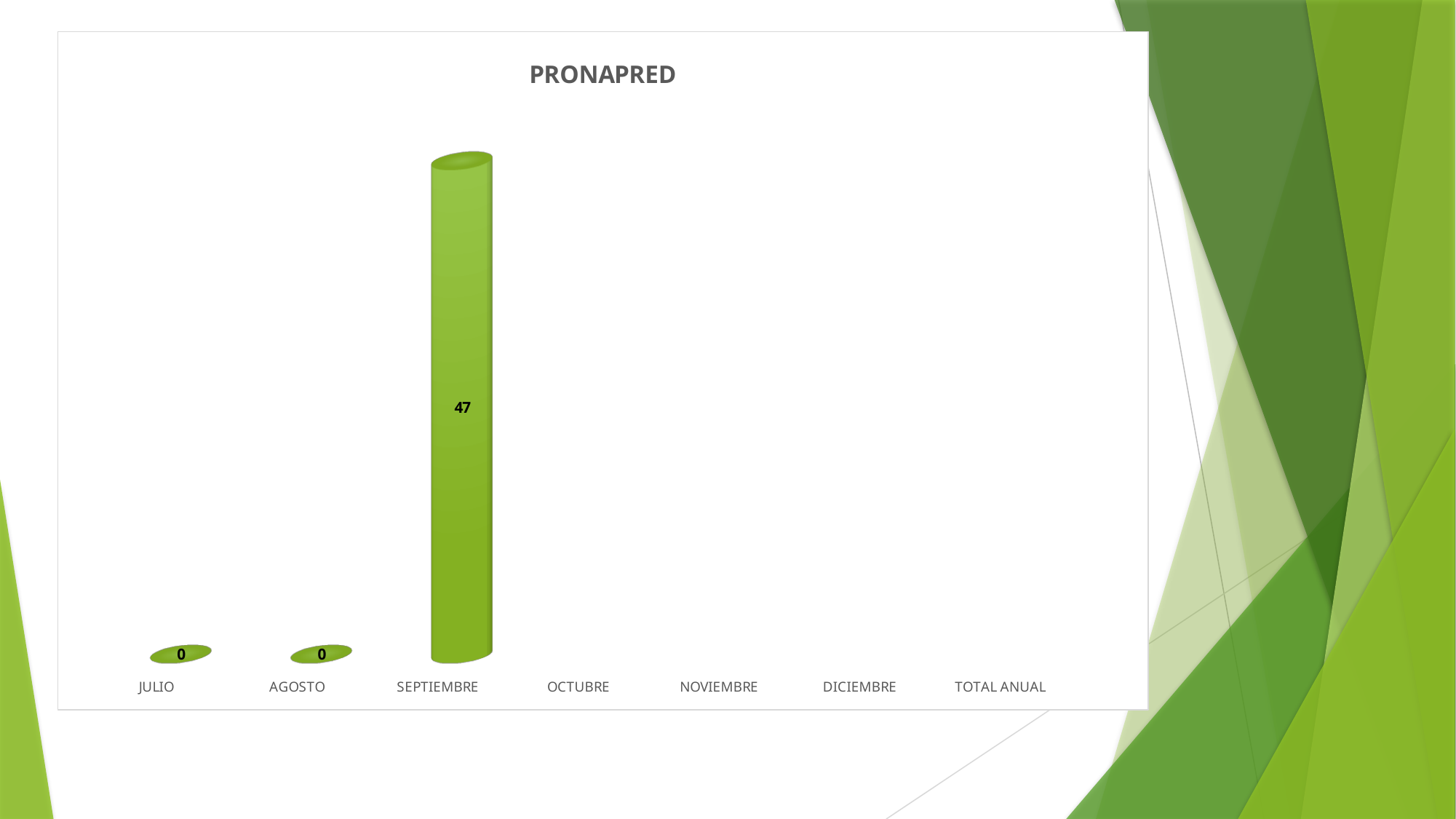
What is the difference between the values for SEPTIEMBRE and AGOSTO? 47 What is the label of the last category on the x axis? TOTAL ANUAL Which is larger, the value for SEPTIEMBRE or the value for JULIO? SEPTIEMBRE How many categories are shown on the x axis? 7 What is the value for SEPTIEMBRE? 47 Which category has the highest value? SEPTIEMBRE What is the value for JULIO? 0 What kind of chart is shown on the slide? bar chart What is the value for AGOSTO? 0 What is the title of the chart? PRONAPRED